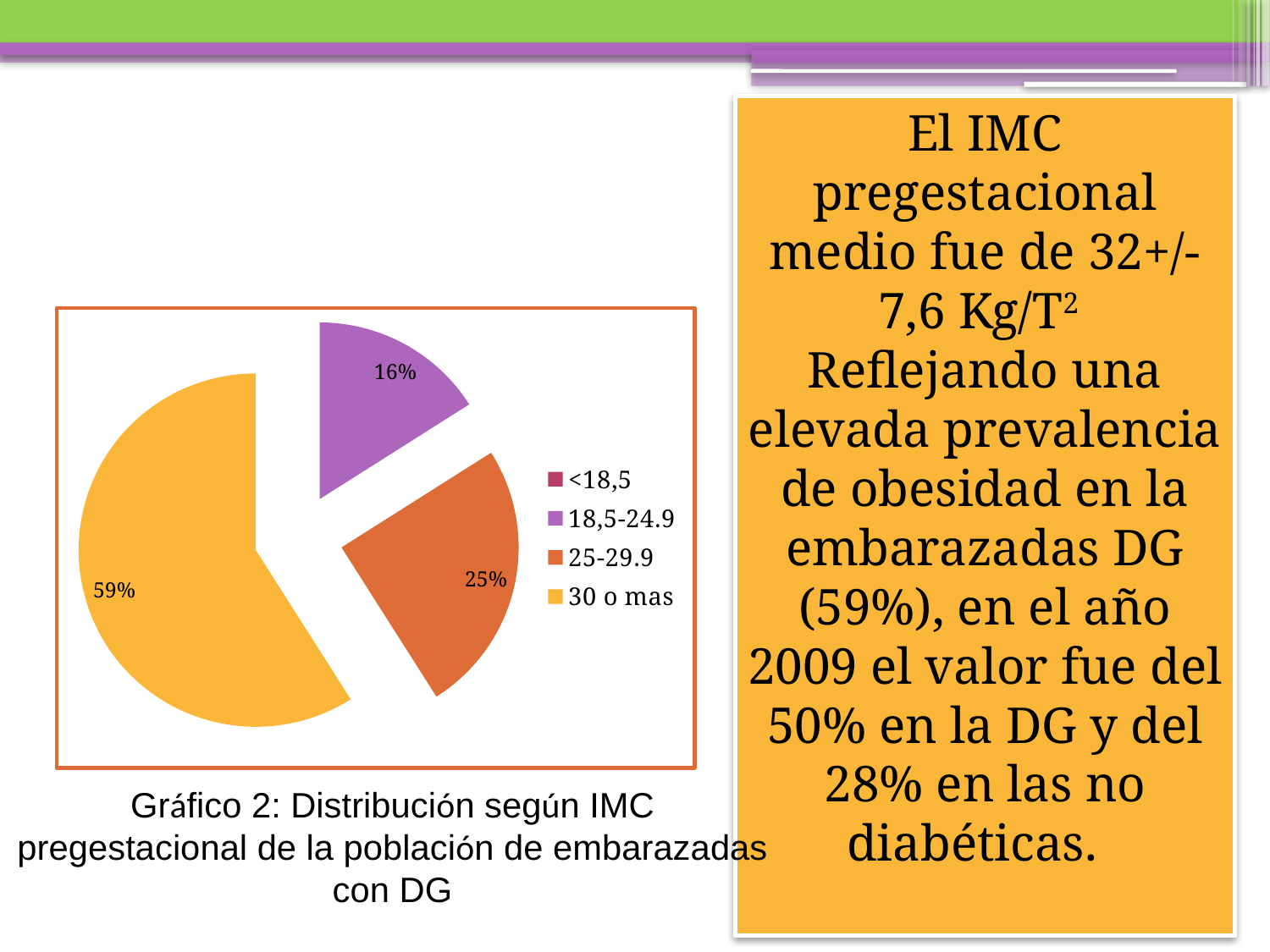
Which slice is larger, "25-29.9" or "18,5-24.9"? 25-29.9 What is the combined share of the "25-29.9" and "30 o mas" slices? 84% Which category has the largest slice of the pie? 30 o mas What is the difference in percentage points between the "30 o mas" slice and the "25-29.9" slice? 34 What kind of chart is shown on the slide? pie chart What colour is the "30 o mas" slice? yellow What share of the pie does the "30 o mas" category have? 59% What share of the pie does the "25-29.9" category have? 25% How many categories does the legend list? 4 What is the caption of the chart? Gráfico 2: Distribución según IMC pregestacional de la población de embarazadas con DG Which of the labelled slices is the smallest? 18,5-24.9 What share of the pie does the "18,5-24.9" category have? 16%